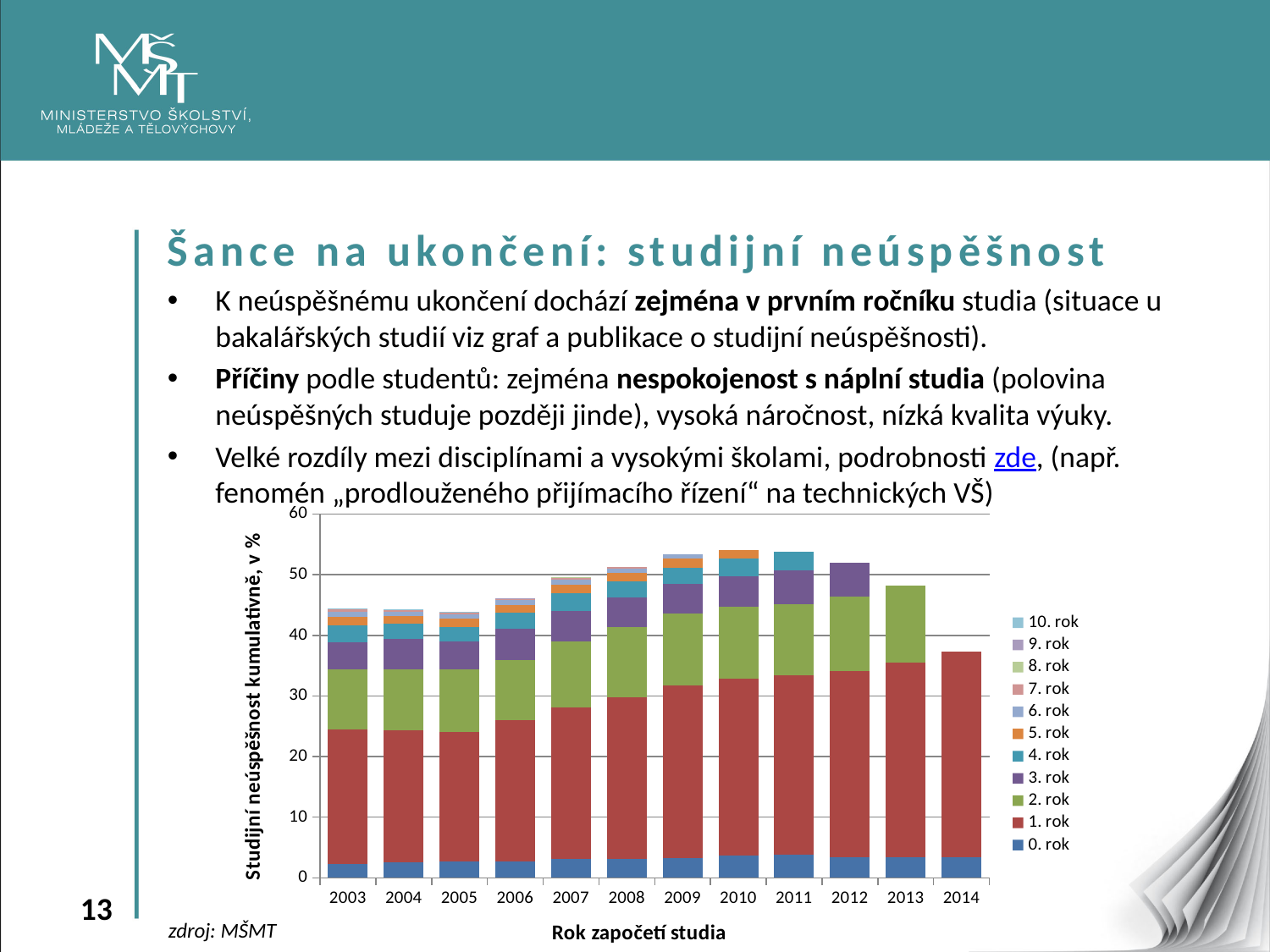
Which year has the larger total bar height, 2005 or 2008? 2008 Is the total bar height for 2011 greater or less than 50? greater What kind of chart is shown on the slide? stacked bar chart Is the total bar height for 2014 greater or less than 40? less How many series does the chart legend list? 11 Which year has the lowest total bar height in the chart? 2014 Does the total bar height rise or fall from 2003 to 2010? rise Is the total bar height for 2013 greater or less than 50? less What is the title of the y axis of the chart? Studijní neúspěšnost kumulativně, v % How many years (categories) are shown on the x axis of the chart? 12 What is the title of the x axis of the chart? Rok započetí studia